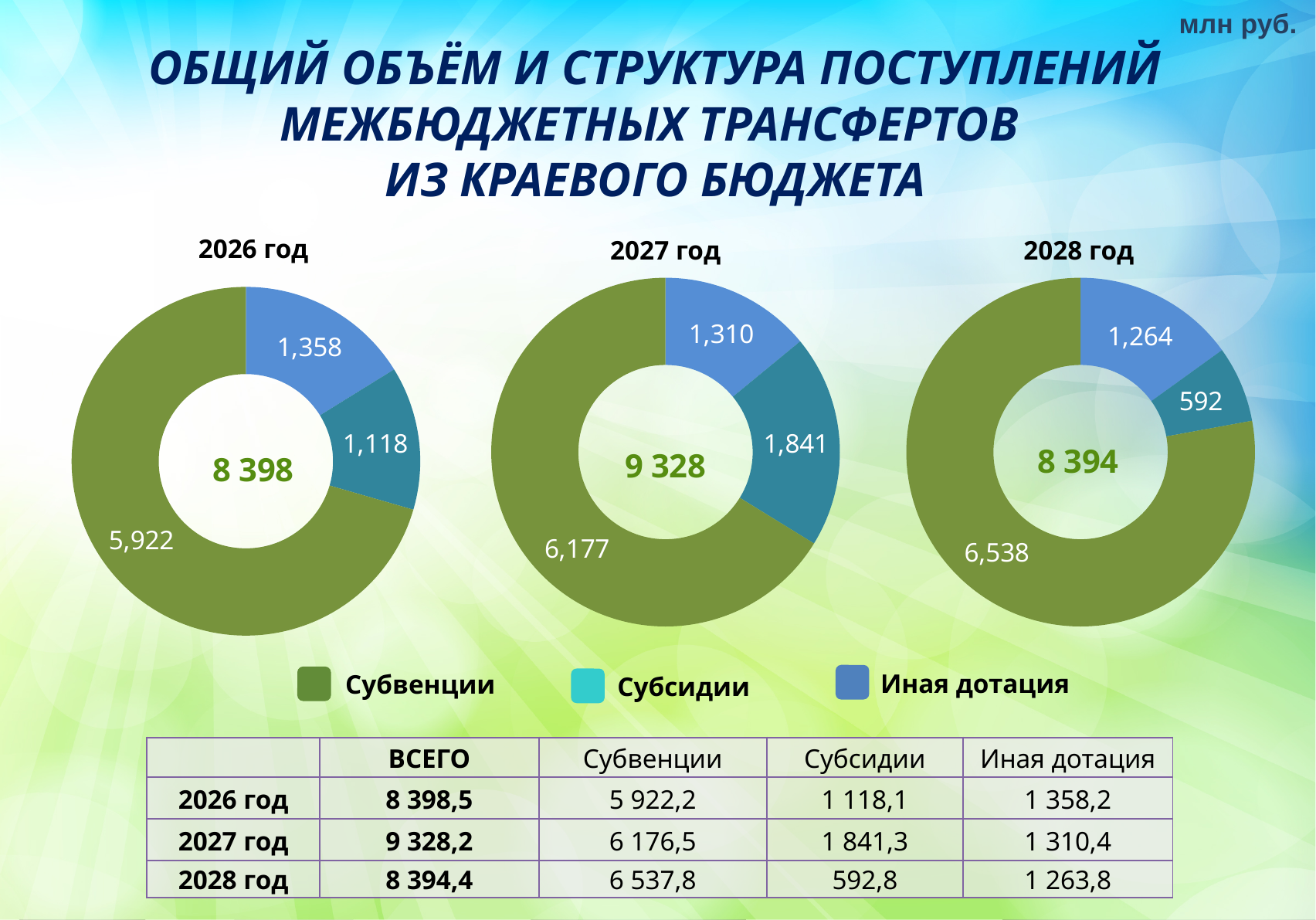
In the 2027 год chart, what is the value for Субсидии? 1,841 How many categories does the legend list? 3 In the 2026 год chart, which is larger: Иная дотация or Субсидии? Иная дотация In the 2026 год chart, what is the value for Субвенции? 5,922 What total is shown in the centre of the 2027 год chart? 9 328 What kind of chart is used for each year on the slide? pie chart (donut) In the 2028 год chart, what is the value for Иная дотация? 1,264 In the 2028 год chart, which category has the smallest slice? Субсидии How many slices does each donut chart have? 3 In the 2027 год chart, what is the difference between Субсидии and Иная дотация? 531 In the 2028 год chart, what is the difference between Иная дотация and Субсидии? 672 In the 2026 год chart, which category has the largest slice? Субвенции